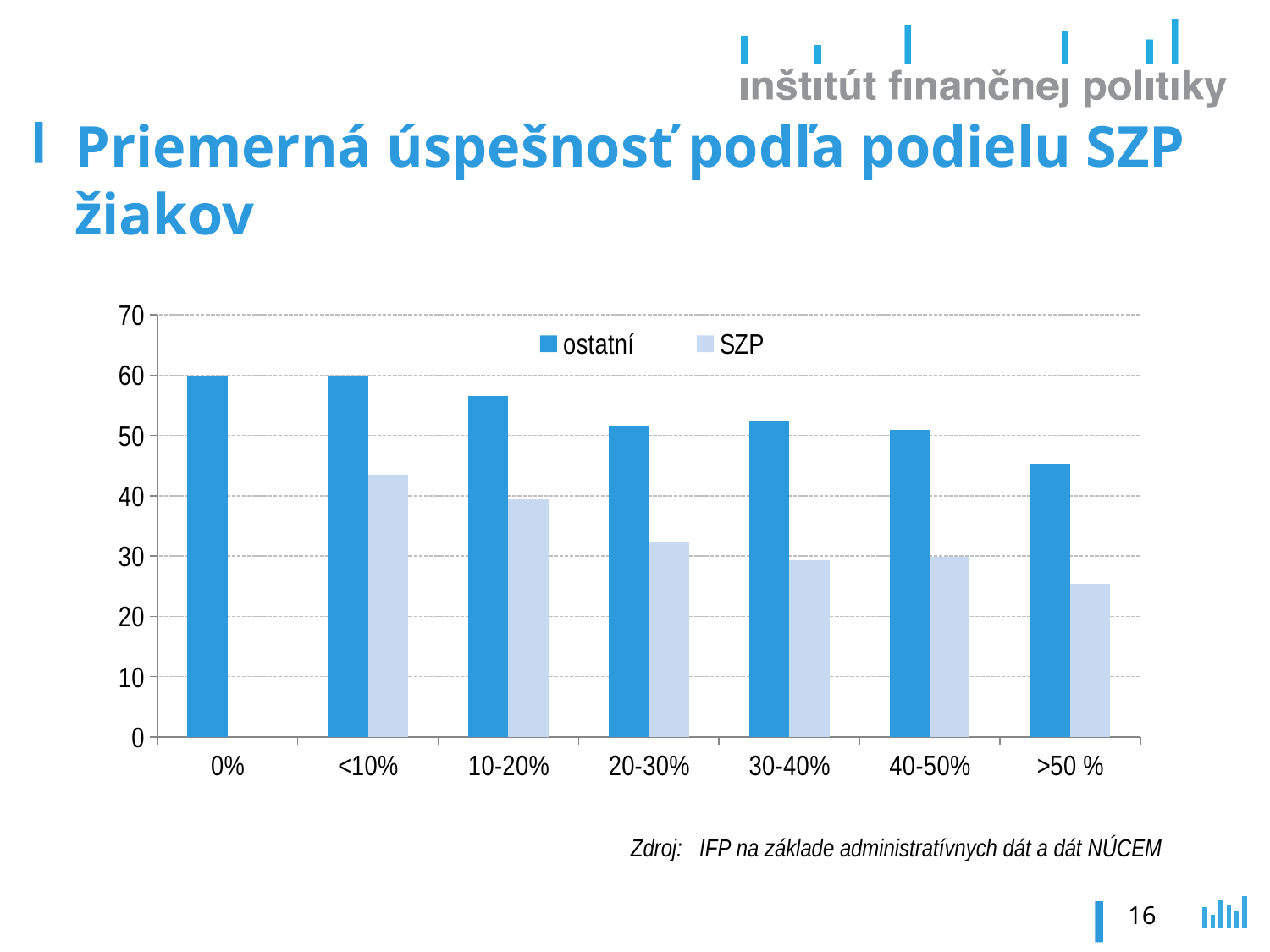
Is the ostatní value for 10-20% greater or less than 50? greater Do the SZP values generally rise or fall as the share of SZP pupils increases along the x axis? fall Is the SZP value for >50 % greater or less than 30? less Is the ostatní value for >50 % greater or less than 50? less Which category has the lowest value for the ostatní series? >50 % In the 20-30% category, which series has the larger value, ostatní or SZP? ostatní Which category has the lowest value for the SZP series? >50 % What kind of chart is shown on the slide? bar chart What are the two series names listed in the legend? ostatní and SZP Which category has the highest value for the SZP series? <10% How many categories are shown on the x axis? 7 How many series does the legend list? 2